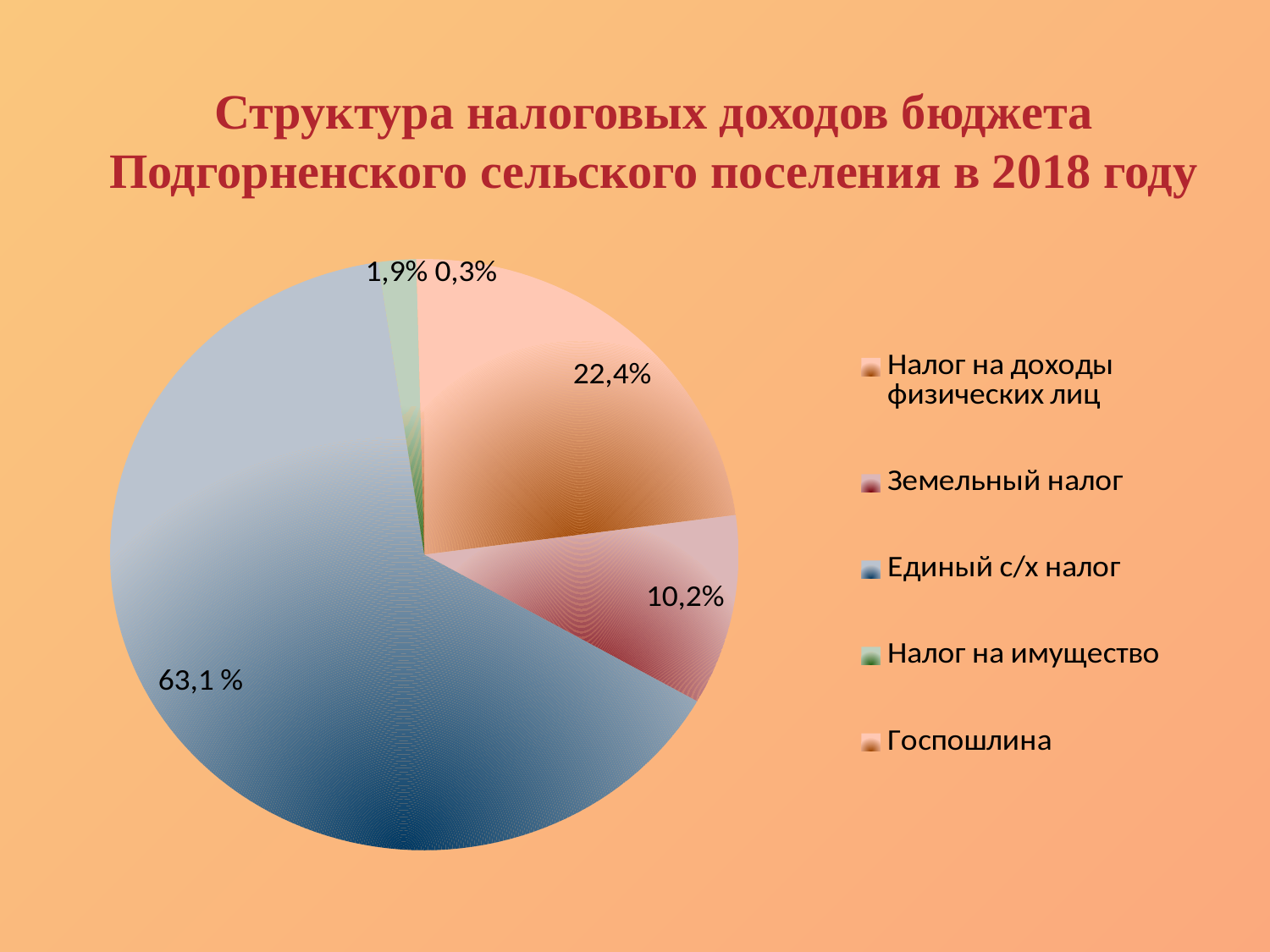
What share of the pie does Госпошлина have? 0,3% How many slices does the pie chart have? 5 What is the difference in percentage points between Налог на доходы физических лиц and Земельный налог? 12,2 Which category has the smallest slice of the pie? Госпошлина What share of the pie does Налог на имущество have? 1,9% What share of the pie does Земельный налог have? 10,2% What share of the pie does Единый с/х налог have? 63,1 % What is the title of the chart on the slide? Структура налоговых доходов бюджета Подгорненского сельского поселения в 2018 году What share of the pie does Налог на доходы физических лиц have? 22,4% Which is larger, the share for Земельный налог or the share for Налог на имущество? Земельный налог Which category has the largest slice of the pie? Единый с/х налог What type of chart is shown on the slide? Pie chart